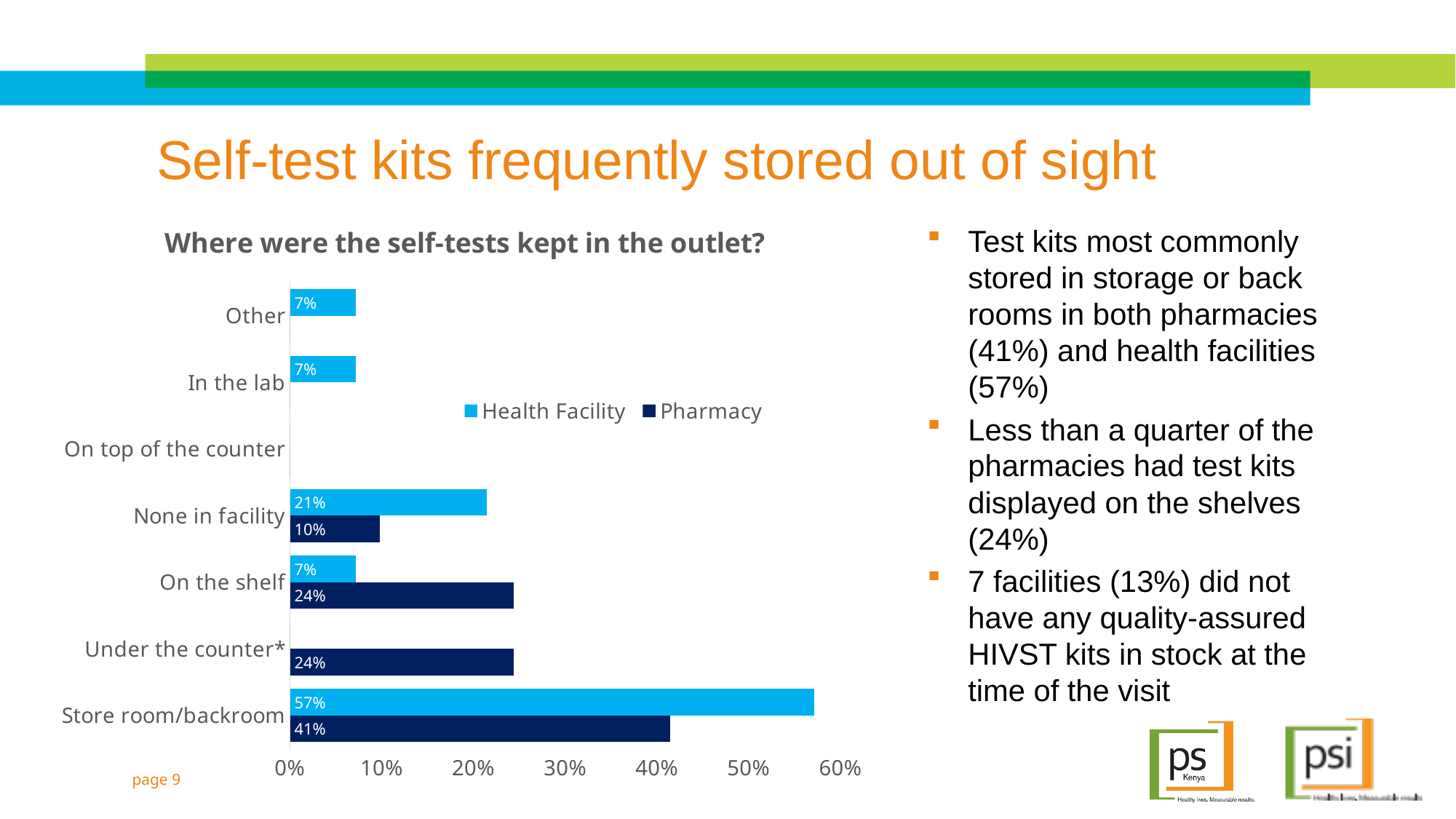
For On the shelf, which is larger: the Health Facility value or the Pharmacy value? Pharmacy What is the Pharmacy value for On the shelf? 24% What is the Pharmacy value for Store room/backroom? 41% How many categories are listed on the vertical axis of the chart? 7 What is the Health Facility value for None in facility? 21% What is the Health Facility value for Store room/backroom? 57% What is the Pharmacy value for Under the counter*? 24% What is the difference between the Health Facility and Pharmacy values for Store room/backroom? 16% What type of chart is shown on the slide? Bar chart How many series does the chart legend list? 2 Which category has the lowest Pharmacy value among those with a Pharmacy bar? None in facility Which category has the highest Health Facility value? Store room/backroom